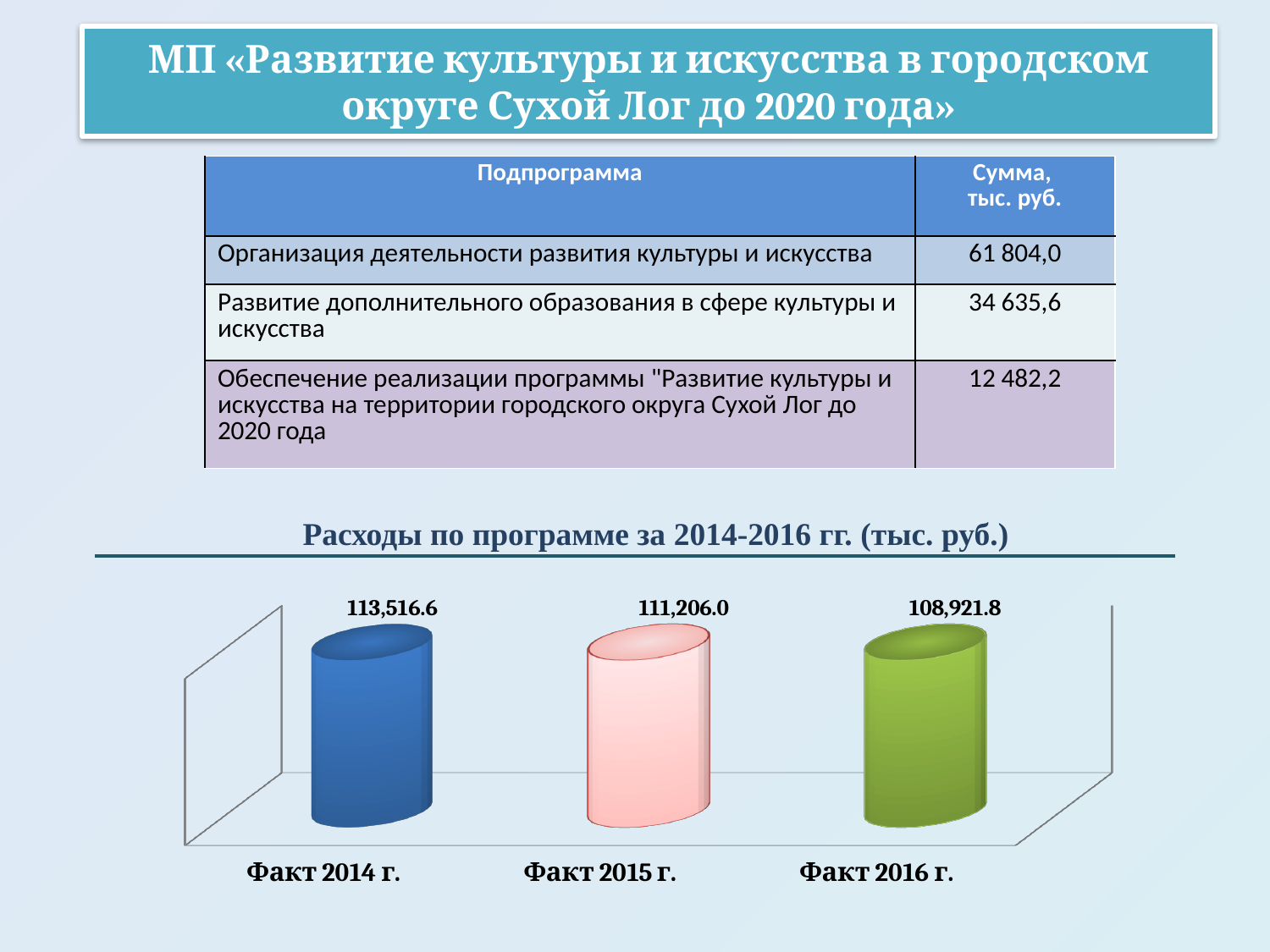
Which category has the highest value in the chart? Факт 2014 г. What is the difference between the values for Факт 2014 г. and Факт 2015 г.? 2,310.6 Which category has the lowest value in the chart? Факт 2016 г. What is the value for Факт 2014 г. in the chart "Расходы по программе за 2014-2016 гг. (тыс. руб.)"? 113,516.6 What kind of chart is shown on the slide? Bar chart Which is larger, the value for Факт 2014 г. or the value for Факт 2016 г.? Факт 2014 г. What is the difference between the values for Факт 2015 г. and Факт 2016 г.? 2,284.2 What is the value for Факт 2016 г. in the chart? 108,921.8 How many categories are shown in the chart? 3 What is the difference between the values for Факт 2014 г. and Факт 2016 г.? 4,594.8 What is the value for Факт 2015 г. in the chart? 111,206.0 Do the values rise or fall from Факт 2014 г. to Факт 2016 г.? Fall